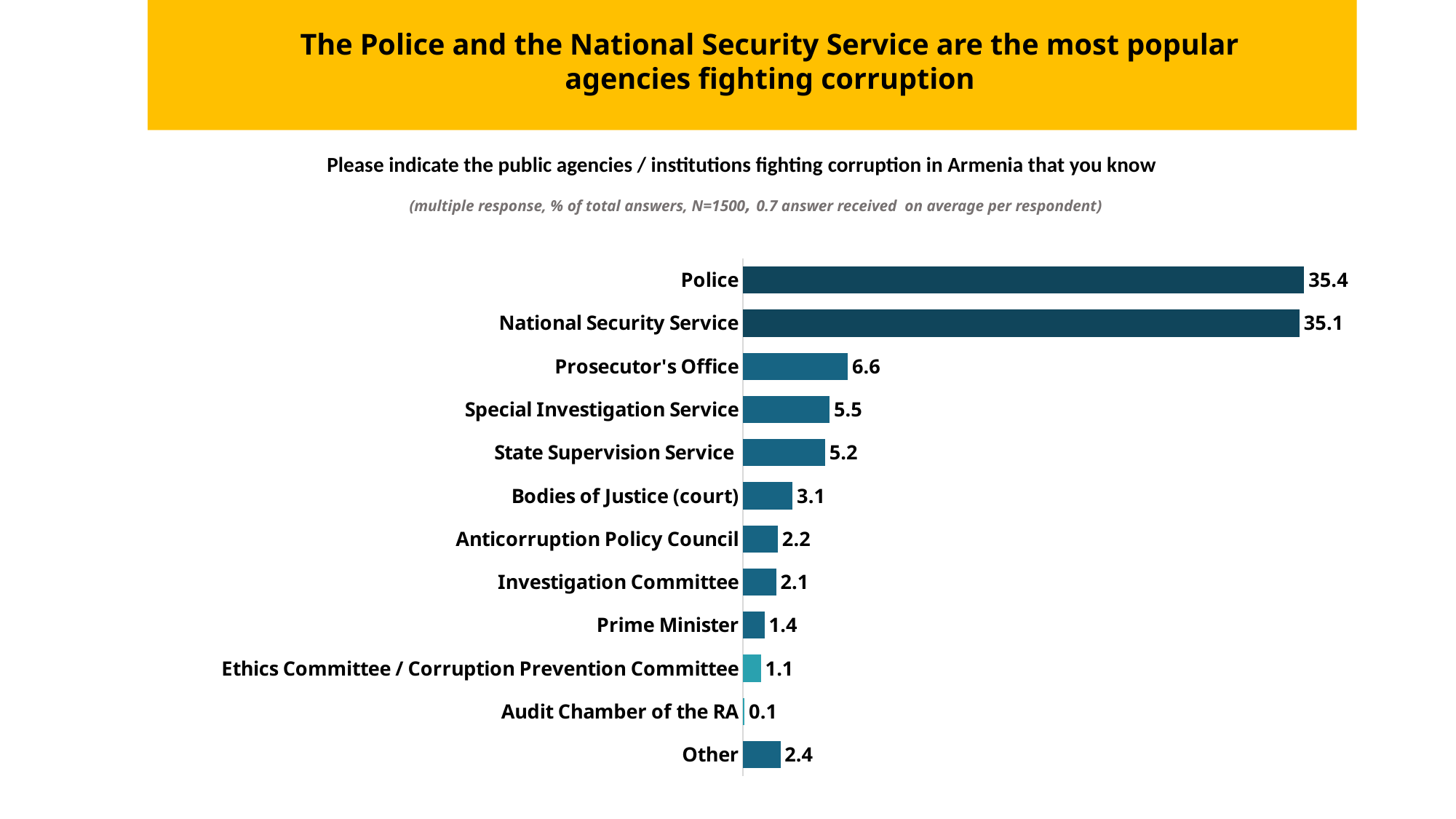
What is the value for Prime Minister? 1.4 What is the value for Police? 35.4 Which category has the lowest value? Audit Chamber of the RA What is the value for Prosecutor's Office? 6.6 What is the value for Audit Chamber of the RA? 0.1 What is the difference between the values for Police and National Security Service? 0.3 Which category has the highest value? Police What kind of chart is shown on the slide? Bar chart What is the value for Ethics Committee / Corruption Prevention Committee? 1.1 What is the difference between the values for Prosecutor's Office and Special Investigation Service? 1.1 Which is larger, the value for Bodies of Justice (court) or the value for Other? Bodies of Justice (court) How many categories are shown in the chart? 12